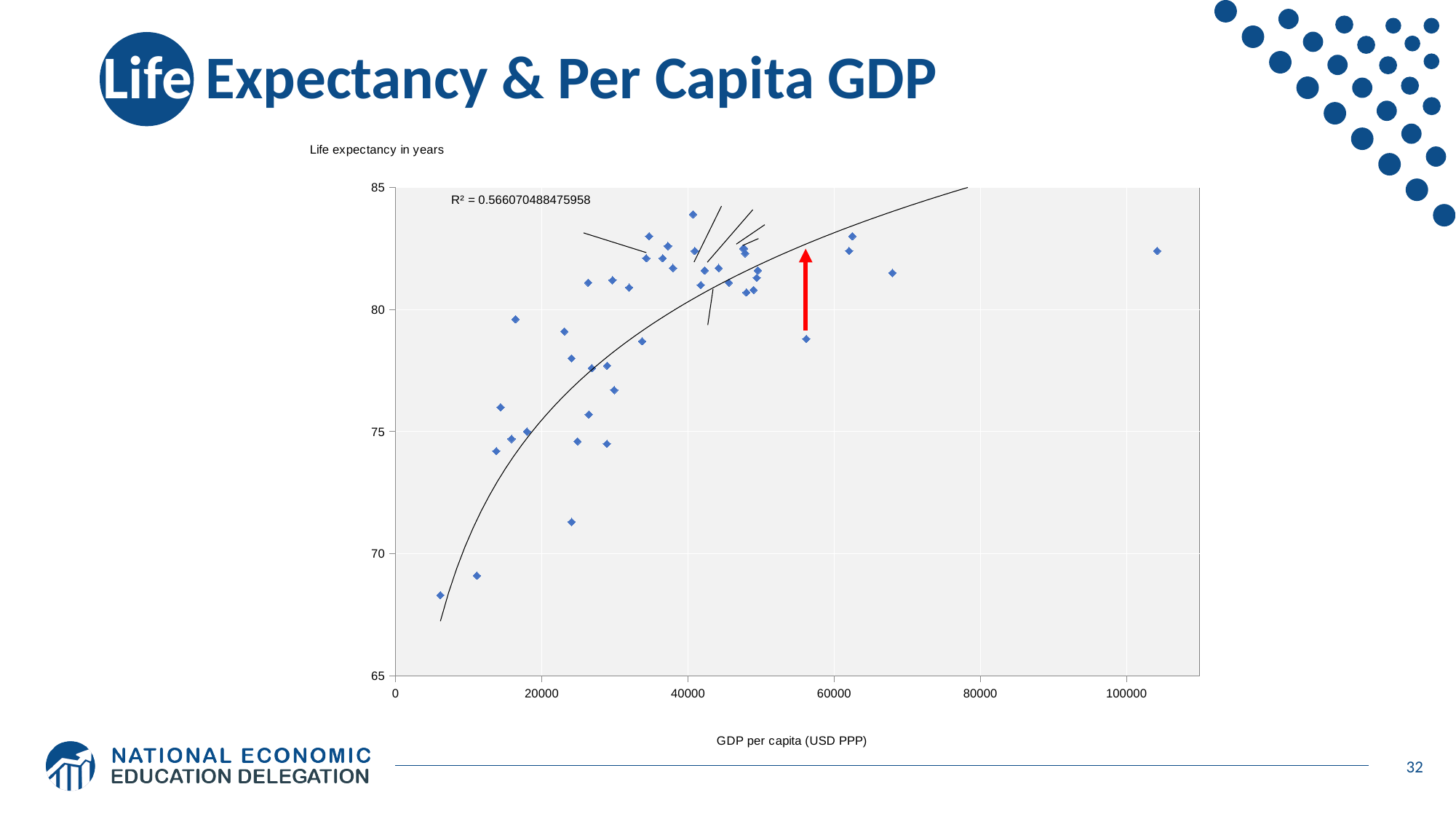
What is the label of the horizontal axis? GDP per capita (USD PPP) Is the GDP per capita of the point with the lowest life expectancy greater or less than 20000? less What is the R² value printed on the chart? R² = 0.566070488475958 What is the maximum value shown on the vertical axis? 85 Is the life expectancy of the highest point on the chart greater or less than 80? greater Is the life expectancy of the point with the highest GDP per capita (just above 100000) greater or less than 80? greater Does life expectancy generally rise or fall as GDP per capita increases along the x axis? rise What kind of chart is shown on the slide? scatter plot Which has the higher life expectancy: the point at about 104000 GDP per capita or the point marked by the red arrow? the point at about 104000 GDP per capita